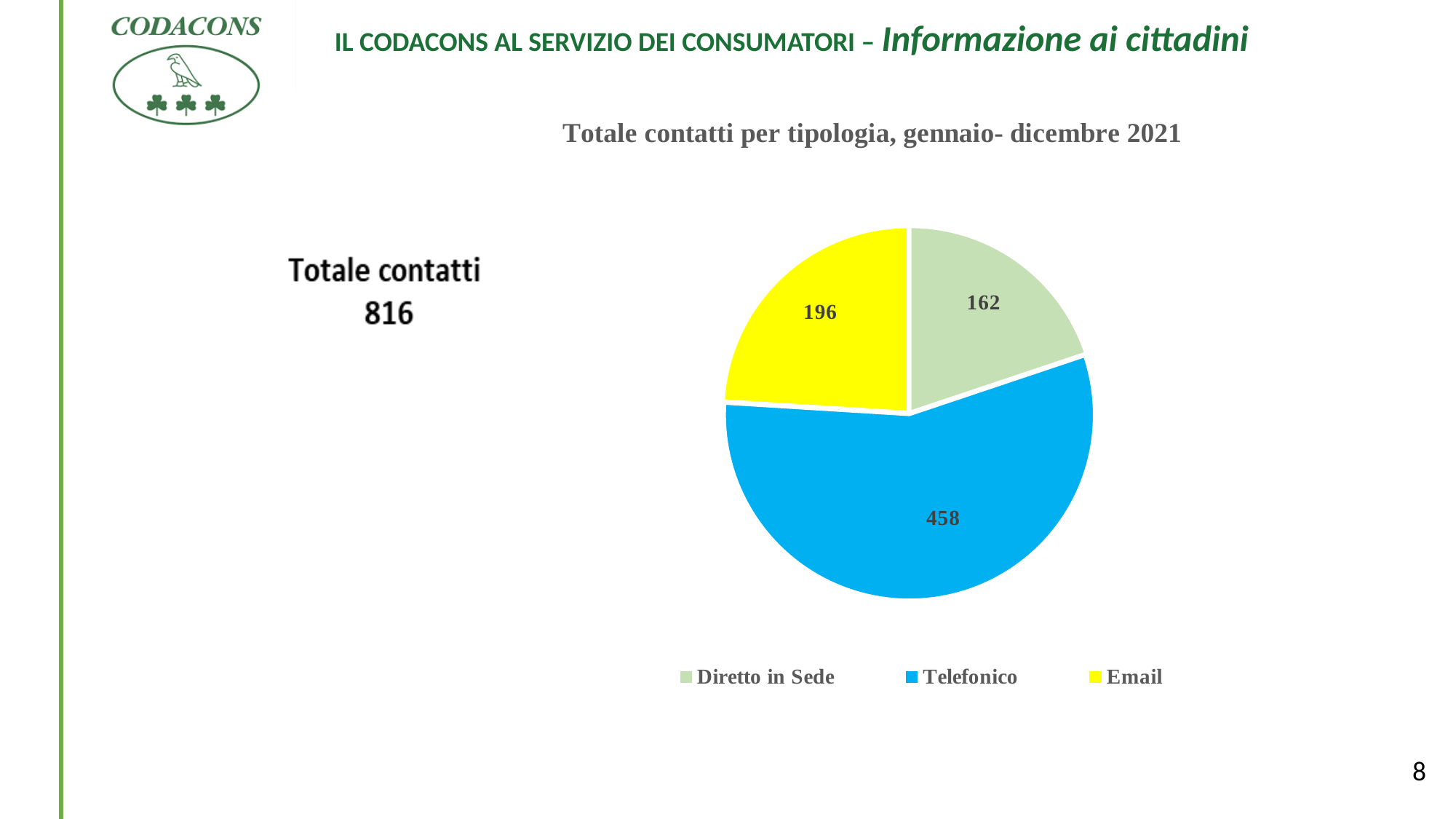
Which contact type has the highest value? Telefonico Which colour represents Telefonico in the pie chart? blue What is the value for Diretto in Sede? 162 What is the difference between the Telefonico and Email values? 262 How many slices does the pie chart have? 3 What is the title of the chart? Totale contatti per tipologia, gennaio- dicembre 2021 Which contact type has the lowest value? Diretto in Sede Which is larger, Email or Diretto in Sede? Email What type of chart is shown on the slide? pie chart What is the difference between the Email and Diretto in Sede values? 34 What is the value for Telefonico? 458 What is the value for Email? 196